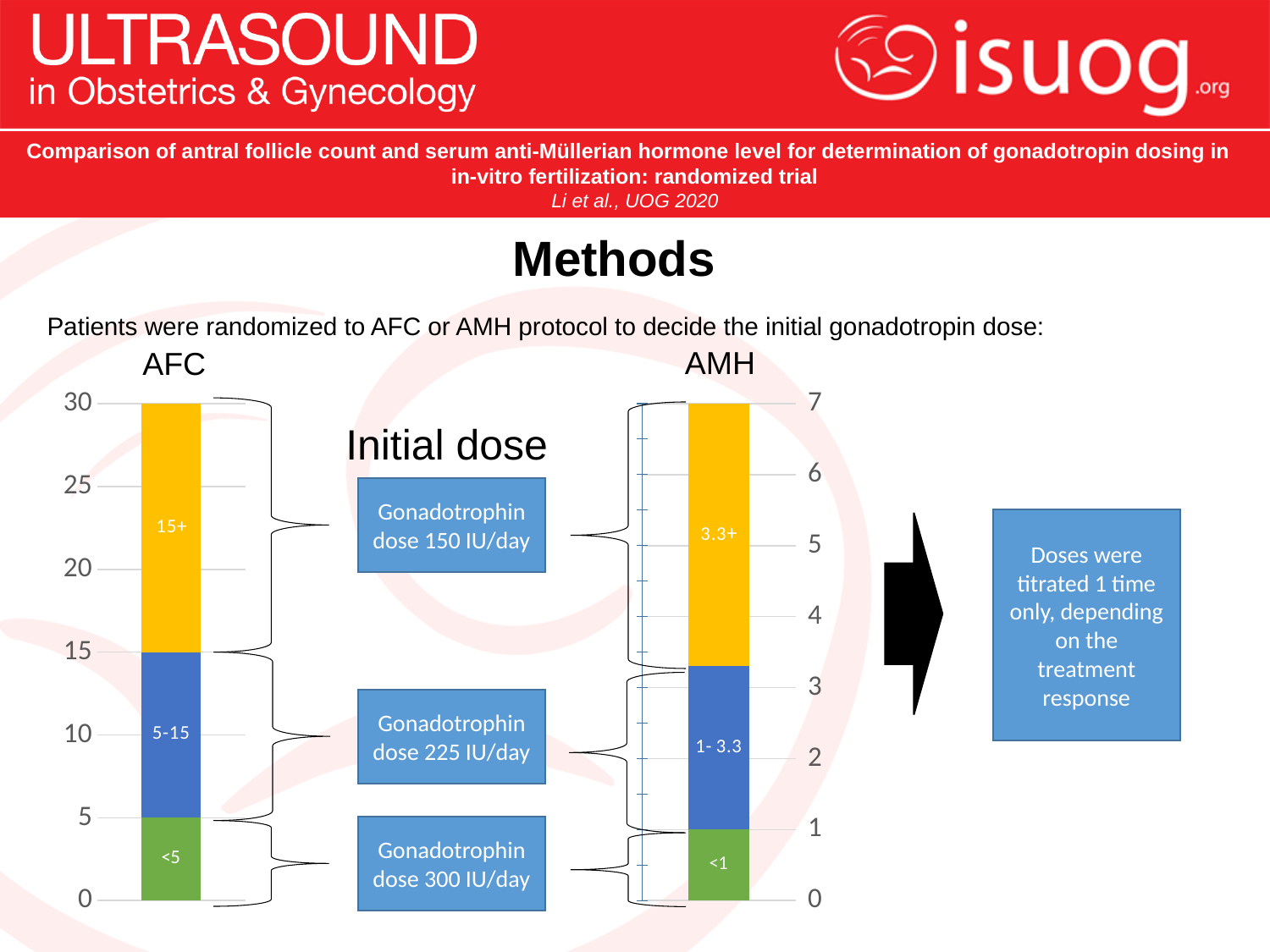
In the AFC chart, which segment covers the largest range of the axis? 15+ (yellow) In the AMH chart, what label is printed on the blue (middle) segment? 1- 3.3 In the AFC chart, what label is printed on the yellow (top) segment? 15+ In the AMH chart, what label is printed on the yellow (top) segment? 3.3+ How many segments make up the bar in the AMH chart? 3 How many segments make up the bar in the AFC chart? 3 In the AFC chart, what label is printed on the green (bottom) segment? <5 What is the highest value shown on the y axis of the AFC chart? 30 What is the highest value shown on the y axis of the AMH chart? 7 What kind of chart is the AFC chart on the left? stacked bar chart In the AMH chart, is the top of the blue segment greater or less than 3 on the axis? greater In the AMH chart, which segment covers the smallest range of the axis? <1 (green)